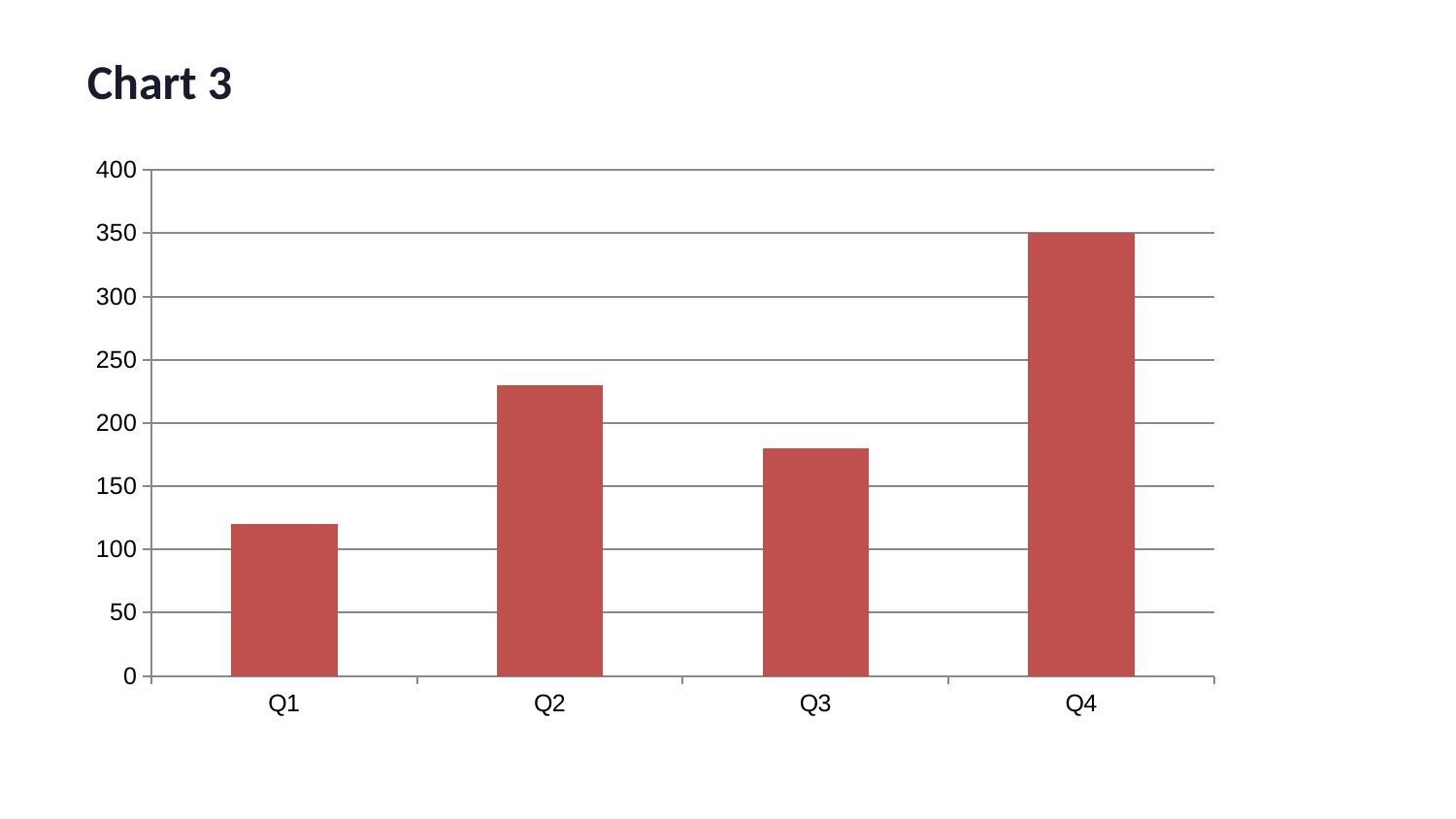
Which quarter has the highest value? Q4 Which quarter has the lowest value? Q1 Which is larger, the value for Q2 or the value for Q3? Q2 How many categories are plotted on the x axis? 4 Is the value for Q3 greater or less than 200? less What kind of chart is shown on the slide? bar chart Is the value for Q1 greater or less than 150? less Is the value for Q1 greater or less than 100? greater Does the value rise or fall from Q2 to Q3? fall What is the title of the chart? Chart 3 What is the value for Q4? 350